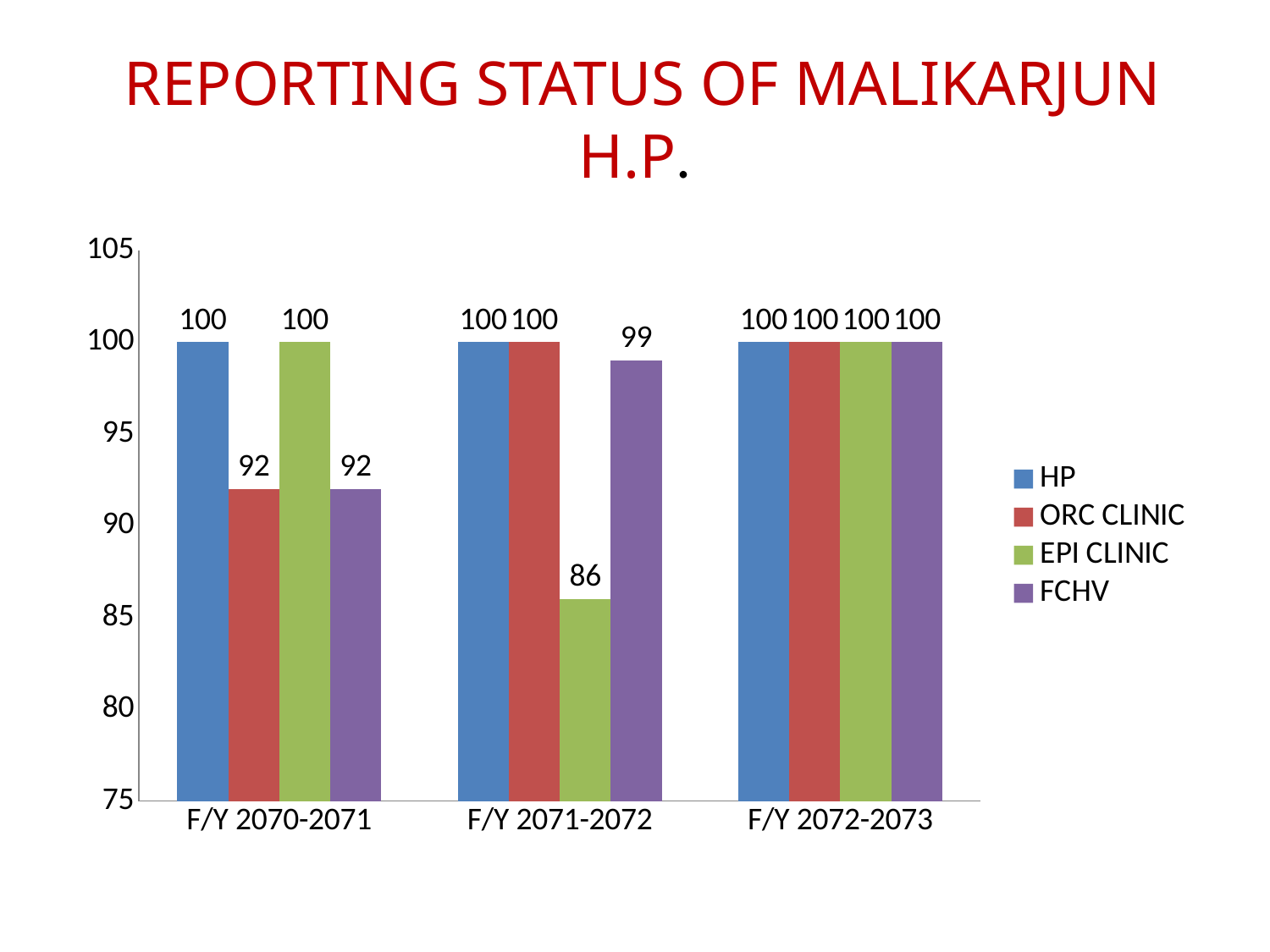
What is the value for HP in F/Y 2072-2073? 100 What kind of chart is shown on the slide? Bar chart Does the ORC CLINIC value rise or fall from F/Y 2070-2071 to F/Y 2071-2072? Rise What is the value for ORC CLINIC in F/Y 2070-2071? 92 What is the value for EPI CLINIC in F/Y 2071-2072? 86 How many fiscal year categories are shown on the x axis? 3 What is the difference between the FCHV value and the EPI CLINIC value in F/Y 2071-2072? 13 What is the difference between the HP value and the ORC CLINIC value in F/Y 2070-2071? 8 What is the value for FCHV in F/Y 2071-2072? 99 How many series does the legend list? 4 Which series has the lowest value in F/Y 2071-2072? EPI CLINIC Which is larger in F/Y 2070-2071, the EPI CLINIC value or the FCHV value? EPI CLINIC